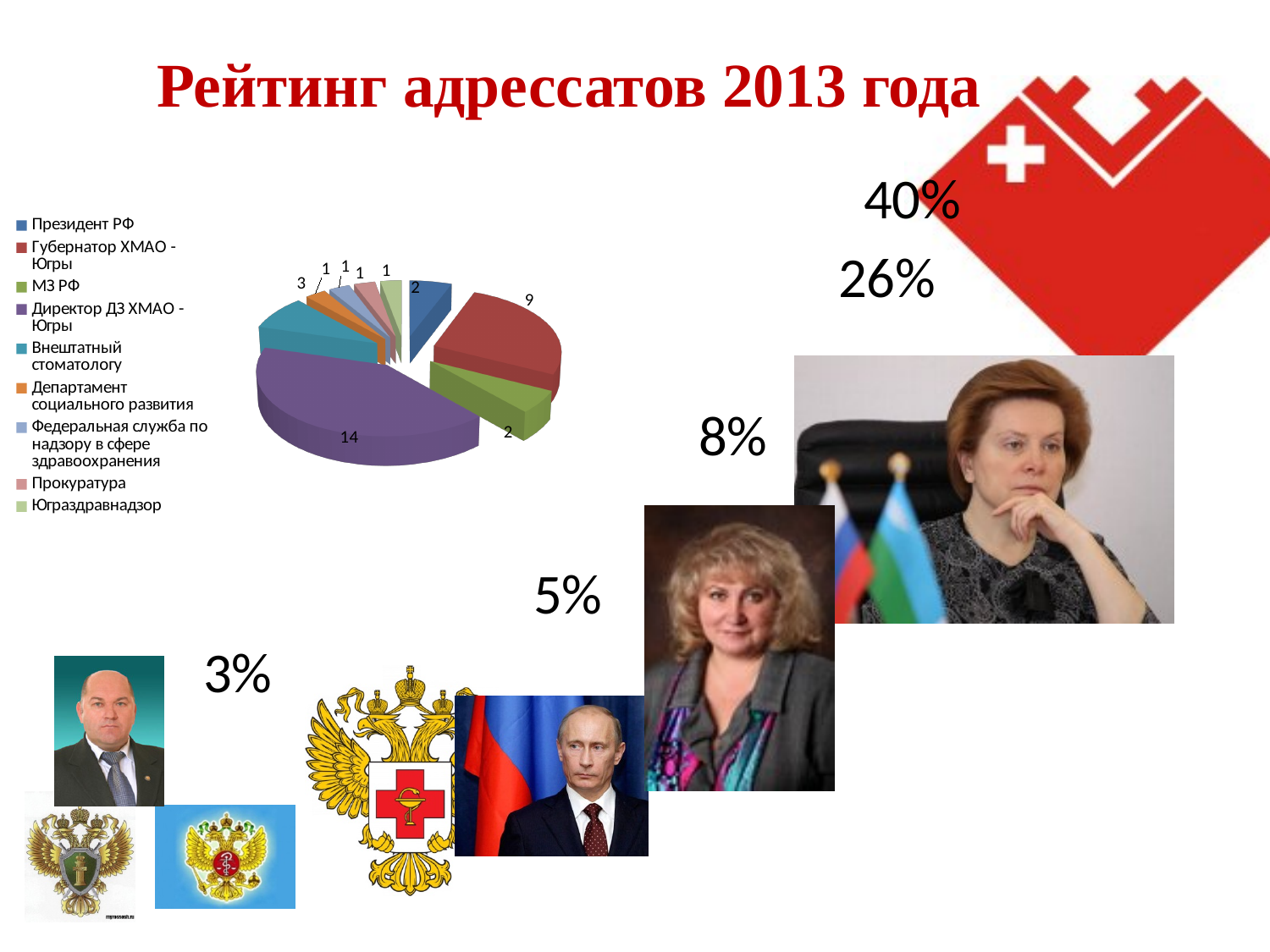
What is the value for Губернатор ХМАО - Югры in the pie chart? 9 What is the value for Директор ДЗ ХМАО - Югры in the pie chart? 14 What is the value for Внештатный стоматологу in the pie chart? 3 What kind of chart is shown on the slide? Pie chart Which is larger in the pie chart: Губернатор ХМАО - Югры or МЗ РФ? Губернатор ХМАО - Югры What is the difference between the values for Директор ДЗ ХМАО - Югры and Губернатор ХМАО - Югры? 5 How many categories does the pie chart legend list? 9 What is the title of the slide containing the pie chart? Рейтинг адрессатов 2013 года What colour is the slice for Директор ДЗ ХМАО - Югры? Purple What is the value for Президент РФ in the pie chart? 2 Which category has the largest slice in the pie chart? Директор ДЗ ХМАО - Югры What is the total of all the slice values in the pie chart? 34